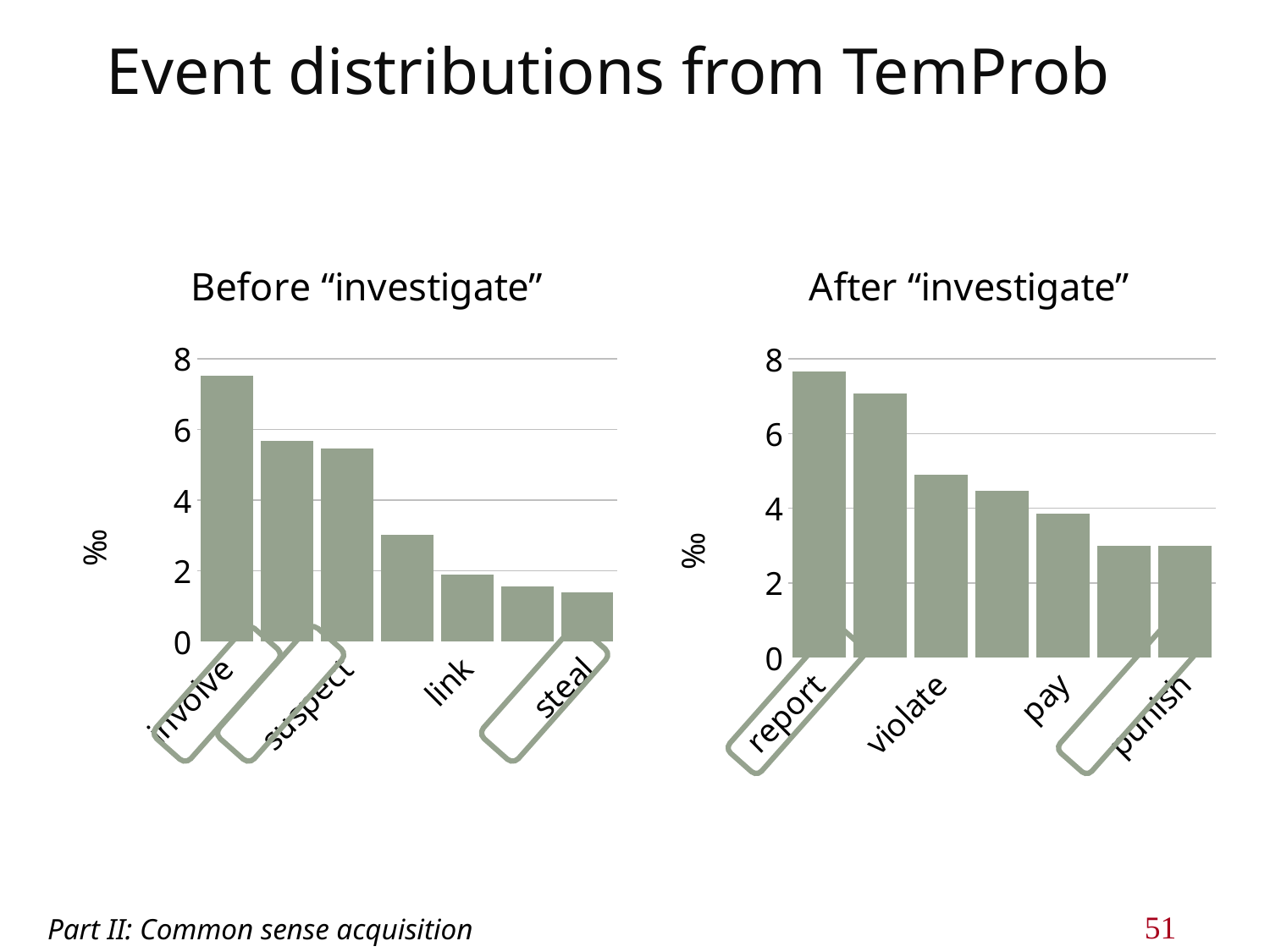
In the "After "investigate"" chart, which is larger, report or violate? report Do the bar values in the "After "investigate"" chart rise or fall from left to right? fall How many bars does the "After "investigate"" chart have? 7 In the "Before "investigate"" chart, is the value for involve greater or less than 6? greater In the "Before "investigate"" chart, which category has the highest value? involve In the "After "investigate"" chart, is the value for violate greater or less than 4? greater In the "Before "investigate"" chart, is the value for suspect greater or less than 6? less What kind of chart is the "Before "investigate"" chart? bar chart In the "After "investigate"" chart, which category has the highest value? report In the "Before "investigate"" chart, which labelled category has the lowest value? steal How many bars does the "Before "investigate"" chart have? 7